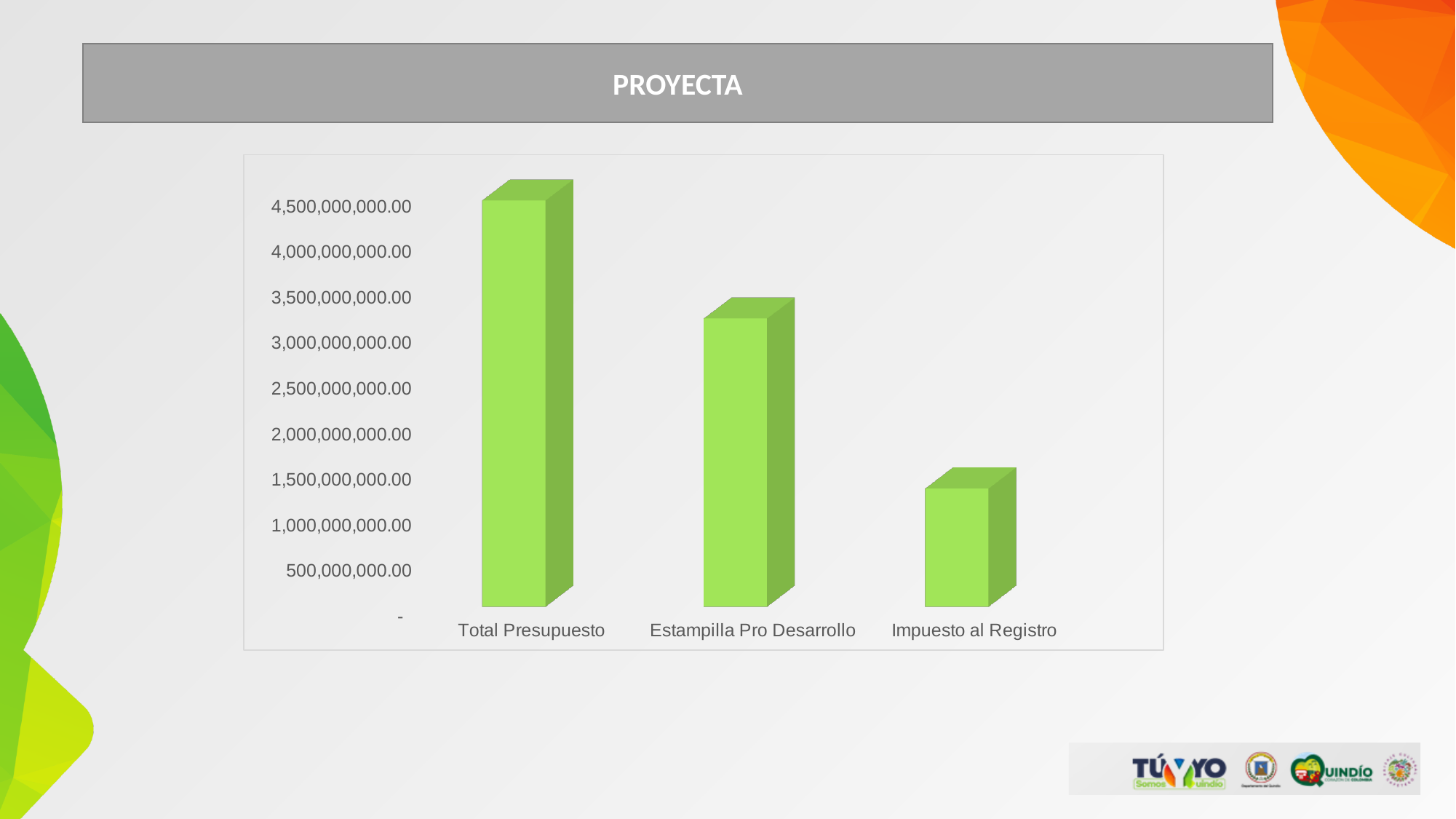
Is the value for Total Presupuesto greater or less than 4,000,000,000.00? greater Is the value for Estampilla Pro Desarrollo greater or less than 3,500,000,000.00? less Is the value for Estampilla Pro Desarrollo greater or less than 3,000,000,000.00? greater How many categories are plotted on the chart? 3 What kind of chart is shown on the slide? bar chart What is the title shown above the chart on the slide? PROYECTA Do the values rise or fall from left to right across the categories? fall Which category has the highest value? Total Presupuesto Which is larger, Total Presupuesto or Estampilla Pro Desarrollo? Total Presupuesto Which category has the lowest value? Impuesto al Registro Which is larger, Estampilla Pro Desarrollo or Impuesto al Registro? Estampilla Pro Desarrollo